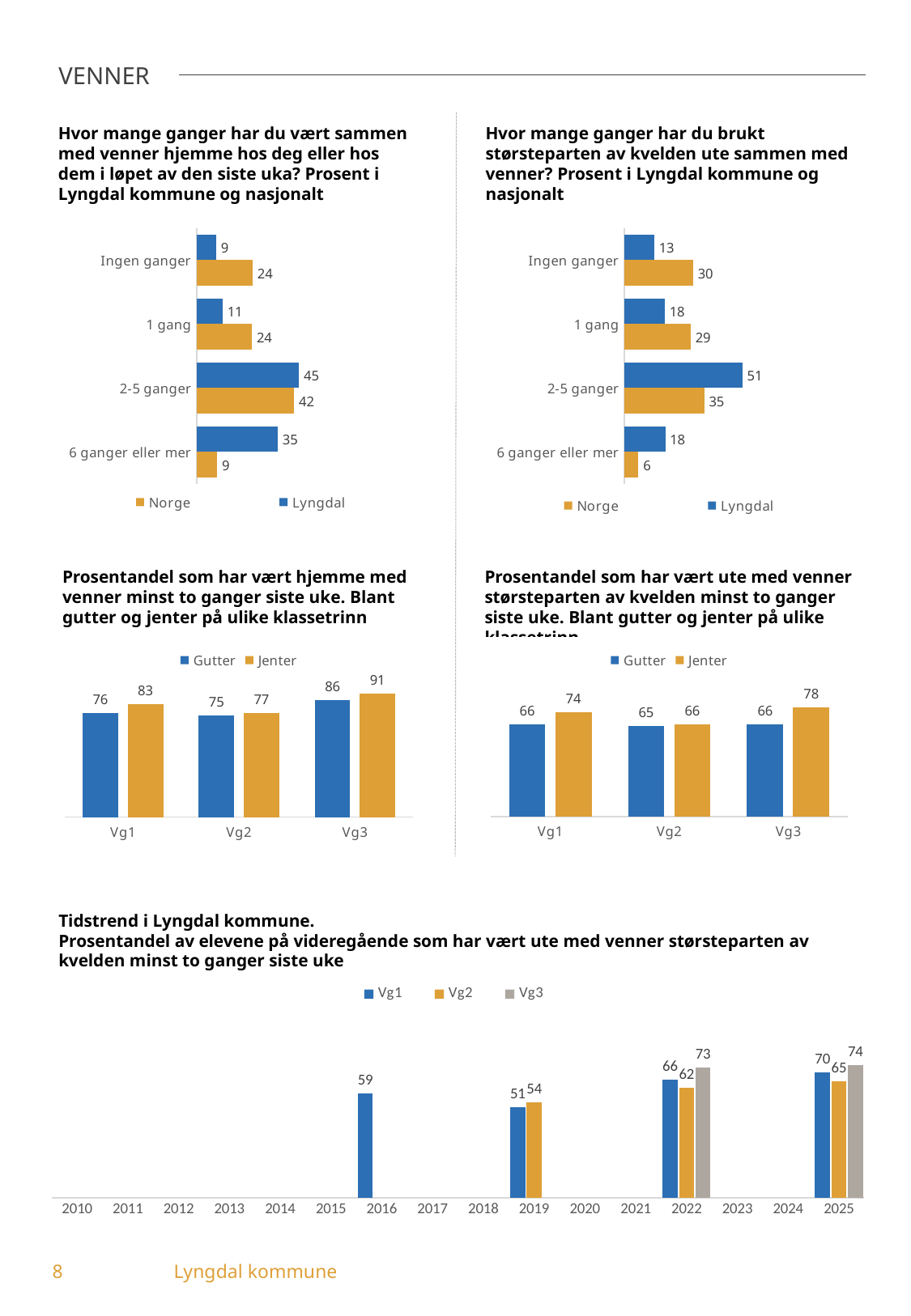
In the chart 'Prosentandel som har vært hjemme med venner minst to ganger siste uke', how many series does the legend list? 2 In the top-left chart (Hvor mange ganger har du vært sammen med venner hjemme...), which category has the highest value for Lyngdal? 2-5 ganger In the bottom chart 'Tidstrend i Lyngdal kommune', what is the value for Vg3 in 2022? 73 In the top-right chart (Hvor mange ganger har du brukt størsteparten av kvelden ute...), which category has the lowest value for Norge? 6 ganger eller mer In the top-right chart (Hvor mange ganger har du brukt størsteparten av kvelden ute...), which is larger for '1 gang': Norge or Lyngdal? Norge In the top-left chart (Hvor mange ganger har du vært sammen med venner hjemme...), what is the difference between Lyngdal and Norge for 'Ingen ganger'? 15 In the chart 'Prosentandel som har vært ute med venner størsteparten av kvelden minst to ganger siste uke', what is the difference between Jenter and Gutter in Vg3? 12 In the top-right chart (Hvor mange ganger har du brukt størsteparten av kvelden ute...), what is the value for Lyngdal for '2-5 ganger'? 51 In the top-left chart (Hvor mange ganger har du vært sammen med venner hjemme...), what is the value for Norge for '6 ganger eller mer'? 9 In the chart 'Prosentandel som har vært hjemme med venner minst to ganger siste uke', what is the value for Jenter in Vg3? 91 In the bottom chart 'Tidstrend i Lyngdal kommune', does the value for Vg1 rise or fall from 2019 to 2025? rise In the chart 'Prosentandel som har vært ute med venner størsteparten av kvelden minst to ganger siste uke', what is the value for Gutter in Vg2? 65